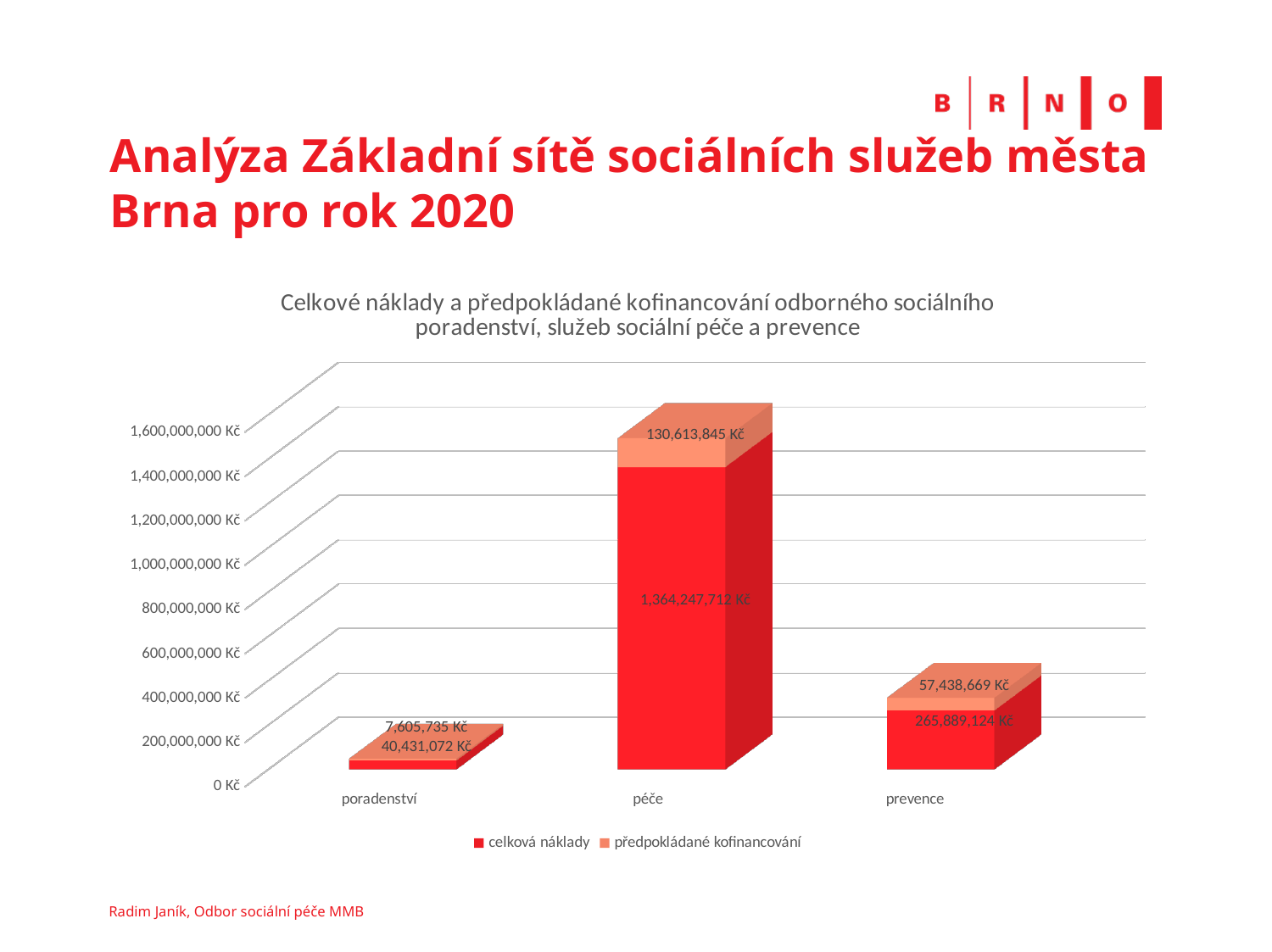
What is the value of celková náklady for péče? 1,364,247,712 Kč What is the value of předpokládané kofinancování for poradenství? 7,605,735 Kč What kind of chart is shown on the slide? stacked bar chart How many series does the legend list? 2 Which is larger: předpokládané kofinancování for péče or for prevence? péče Which category has the lowest předpokládané kofinancování? poradenství How many categories are shown on the x axis? 3 What is the value of předpokládané kofinancování for prevence? 57,438,669 Kč What is the total of the stacked bar for prevence? 323,327,793 Kč What is the value of celková náklady for poradenství? 40,431,072 Kč Which category has the highest celková náklady? péče What is the difference between celková náklady for péče and for prevence? 1,098,358,588 Kč